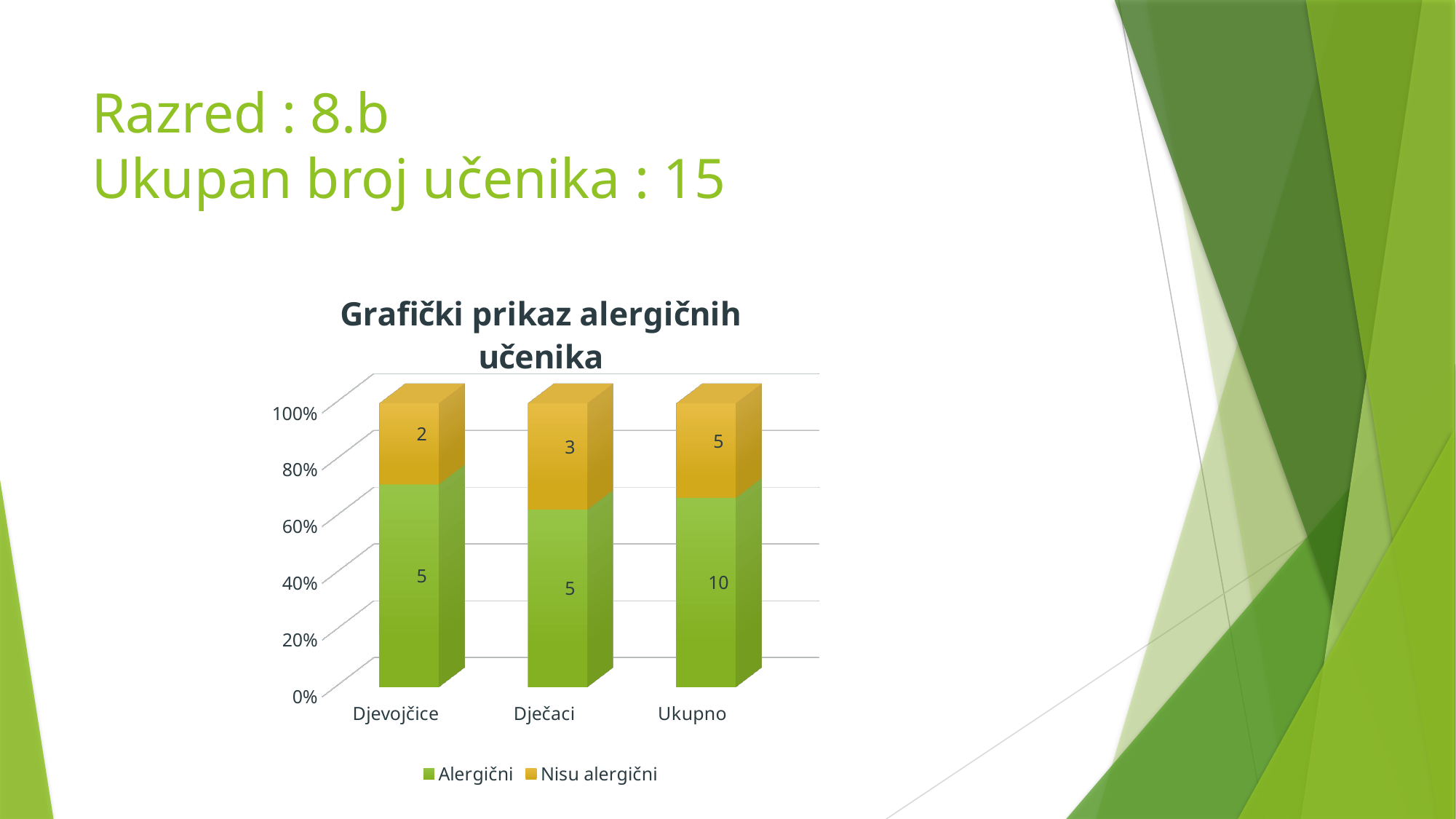
What is the value for Nisu alergični in the Djevojčice category? 2 Which is larger: the Nisu alergični value for Dječaci or the Nisu alergični value for Djevojčice? Dječaci What kind of chart is shown on the slide? Stacked bar chart Which category has the highest value for Nisu alergični? Ukupno What is the difference between the Alergični value for Ukupno and the Alergični value for Dječaci? 5 How many categories are shown on the x axis? 3 How many series does the legend list? 2 Which category has the lowest value for Nisu alergični? Djevojčice What is the value for Alergični in the Djevojčice category? 5 What is the title of the chart? Grafički prikaz alergičnih učenika What is the value for Nisu alergični in the Dječaci category? 3 What is the value for Alergični in the Ukupno category? 10